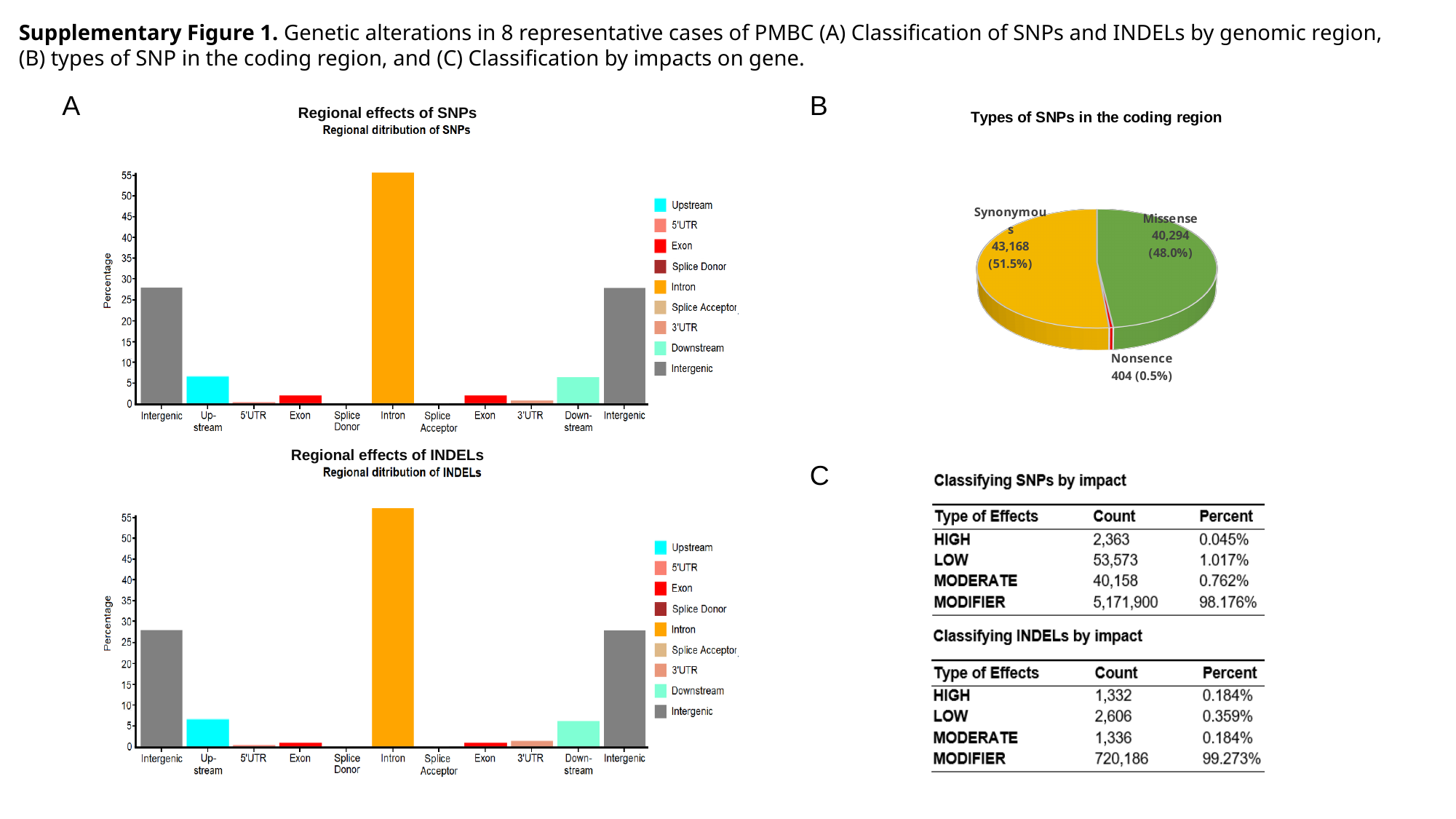
In the 'Regional effects of SNPs' chart, is the value for Intron greater or less than 50? greater In the pie chart 'Types of SNPs in the coding region', what share of the pie is Missense? 48.0% In the pie chart 'Types of SNPs in the coding region', what is the count shown for Synonymous? 43,168 In the 'Regional effects of INDELs' chart, is the value for Upstream greater or less than 10? less What kind of chart is 'Regional effects of INDELs'? Bar chart In the 'Regional effects of SNPs' chart, which category has the highest bar? Intron How many slices does the pie chart 'Types of SNPs in the coding region' have? 3 How many entries does the legend of the 'Regional effects of SNPs' chart list? 9 What kind of chart is 'Types of SNPs in the coding region'? Pie chart In the pie chart 'Types of SNPs in the coding region', which slice is the smallest? Nonsence In the 'Regional effects of SNPs' chart, is the value for Intergenic greater or less than 25? greater In the pie chart 'Types of SNPs in the coding region', what is the difference between the Synonymous count and the Missense count? 2,874